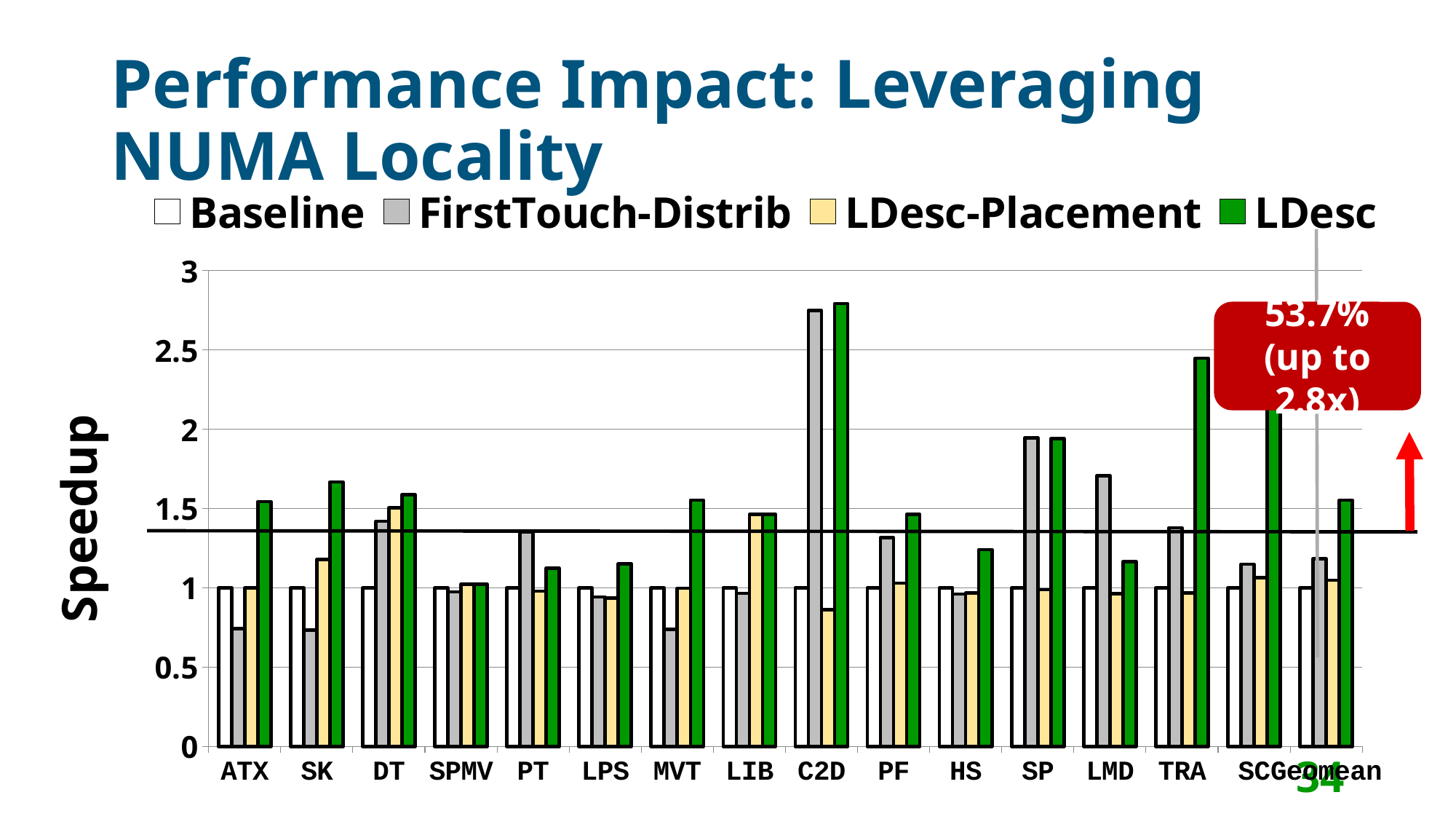
How many series does the legend list? 4 Is the LDesc speedup for HS greater or less than 1.5? less Which is larger, the FirstTouch-Distrib speedup for SP or for LMD? SP What text is shown in the red callout box on the chart? 53.7% (up to 2.8x) Is the LDesc speedup for TRA greater or less than 2? greater How many categories are shown along the x axis? 16 Which category has the highest LDesc speedup? C2D What is the Baseline speedup value for ATX? 1 What is the label of the y axis? Speedup Is the FirstTouch-Distrib speedup for ATX greater or less than 1? less What kind of chart is shown on the slide? bar chart